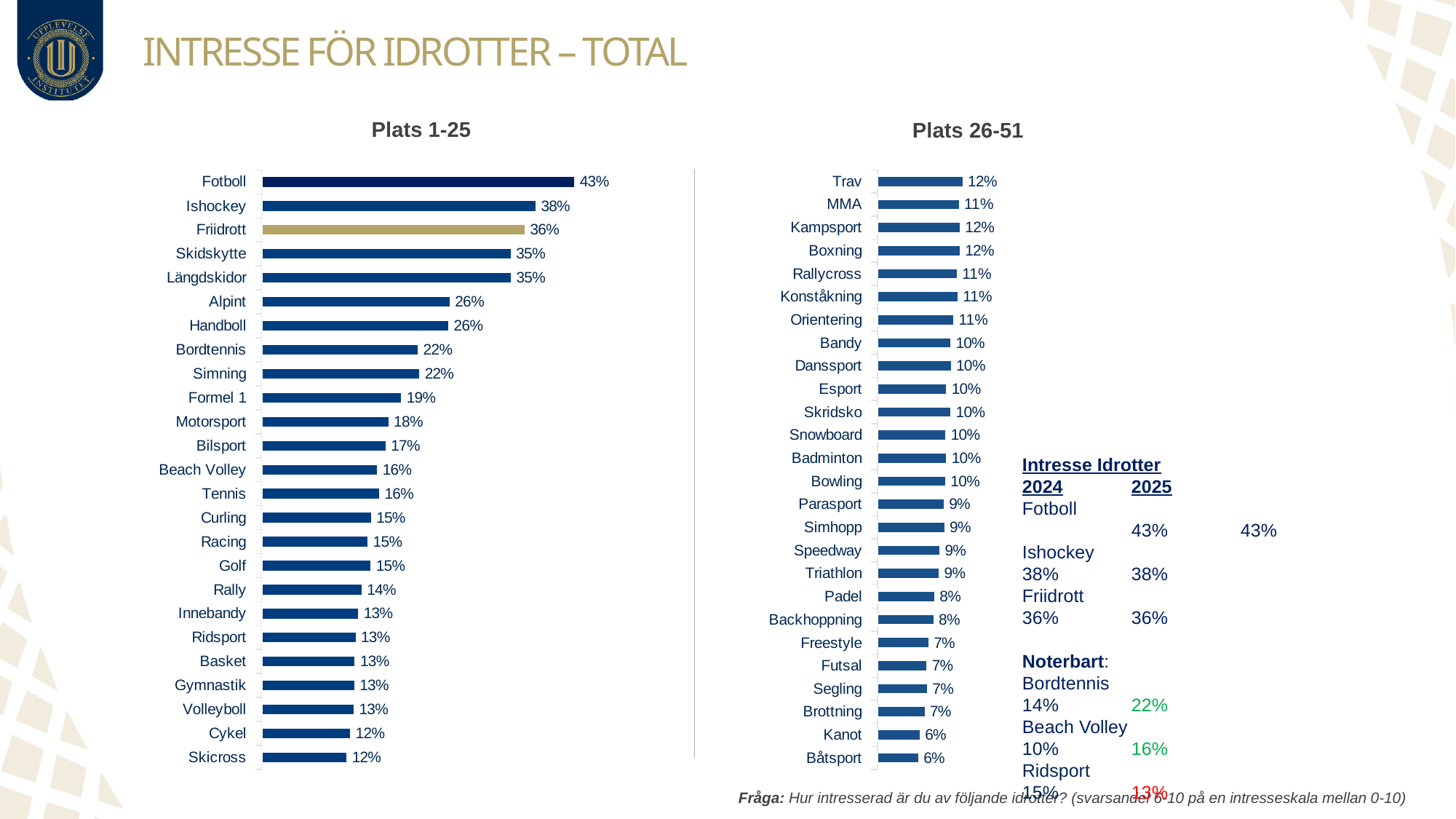
In the 'Plats 1-25' chart, what is the value for Handboll? 26% In the 'Plats 1-25' chart, which category has the highest value? Fotboll In the 'Plats 1-25' chart, what is the value for Fotboll? 43% In the 'Plats 26-51' chart, what is the difference between the values for Trav and Kanot? 6% What kind of chart is the 'Plats 1-25' chart? Bar chart In the 'Plats 26-51' chart, what is the value for Orientering? 11% In the 'Plats 26-51' chart, what is the value for Padel? 8% How many categories are shown in the 'Plats 26-51' chart? 26 In the 'Plats 1-25' chart, which is larger, the value for Alpint or the value for Bordtennis? Alpint In the 'Plats 1-25' chart, what is the difference between the values for Ishockey and Friidrott? 2% In the 'Plats 1-25' chart, which category's bar is coloured gold instead of blue? Friidrott In the 'Plats 26-51' chart, which category has the lowest value? Båtsport and Kanot (both 6%)